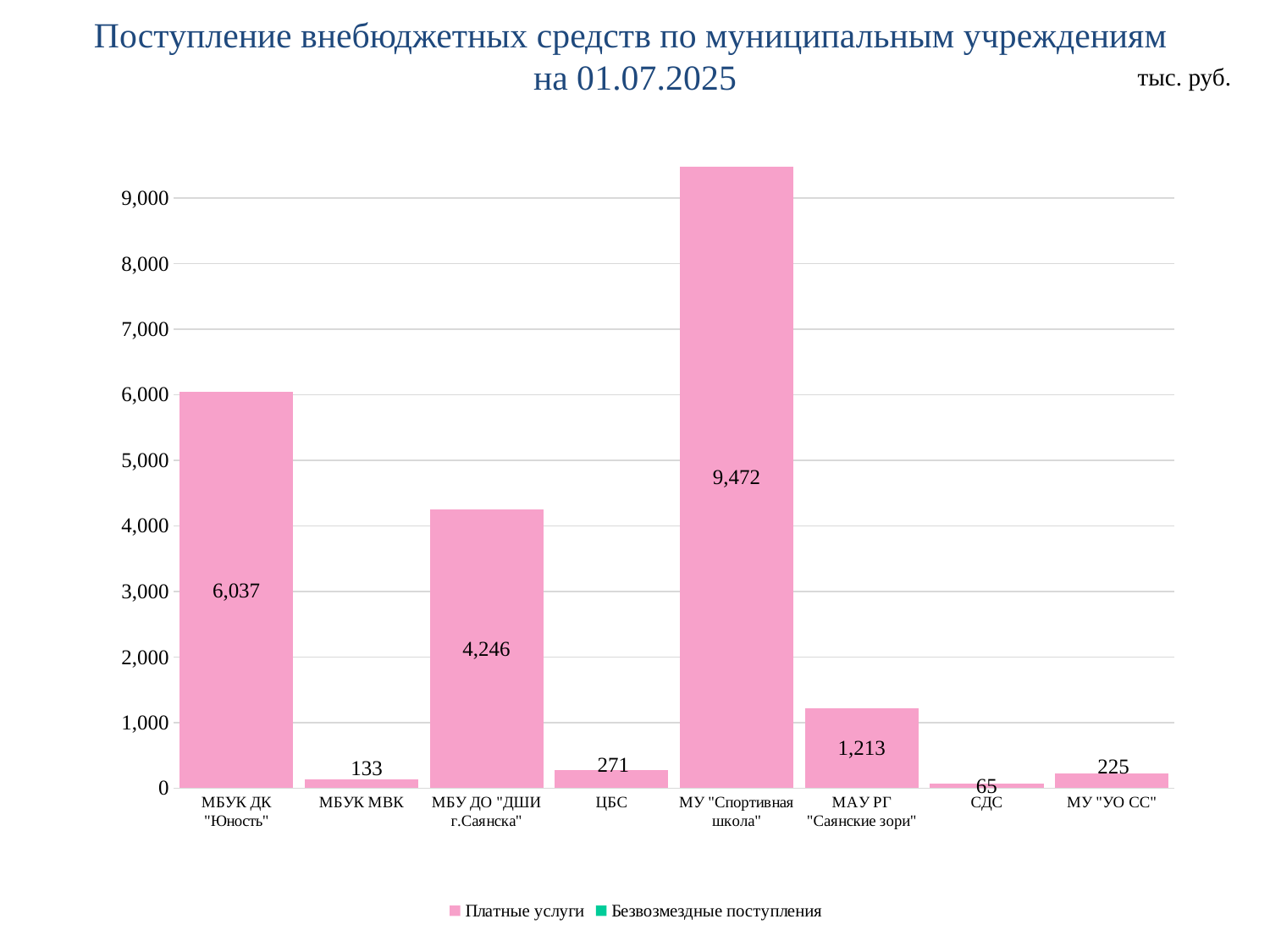
Which is larger, the value for ЦБС or the value for МУ "УО СС"? МУ "УО СС" Which category has the lowest value? СДС How many categories are shown on the x axis? 8 What unit is indicated in the top right corner of the slide? тыс. руб. What is the value for МБУ ДО "ДШИ г.Саянска"? 4,246 How many series does the legend list? 2 Is the value for МАУ РГ "Саянские зори" greater or less than 1,000? greater Which category has the highest value? МУ "Спортивная школа" What is the value for МУ "Спортивная школа"? 9,472 What is the value for СДС? 65 What kind of chart is shown on the slide? bar chart What is the difference between the values for МБУК ДК "Юность" and МБУ ДО "ДШИ г.Саянска"? 1,791